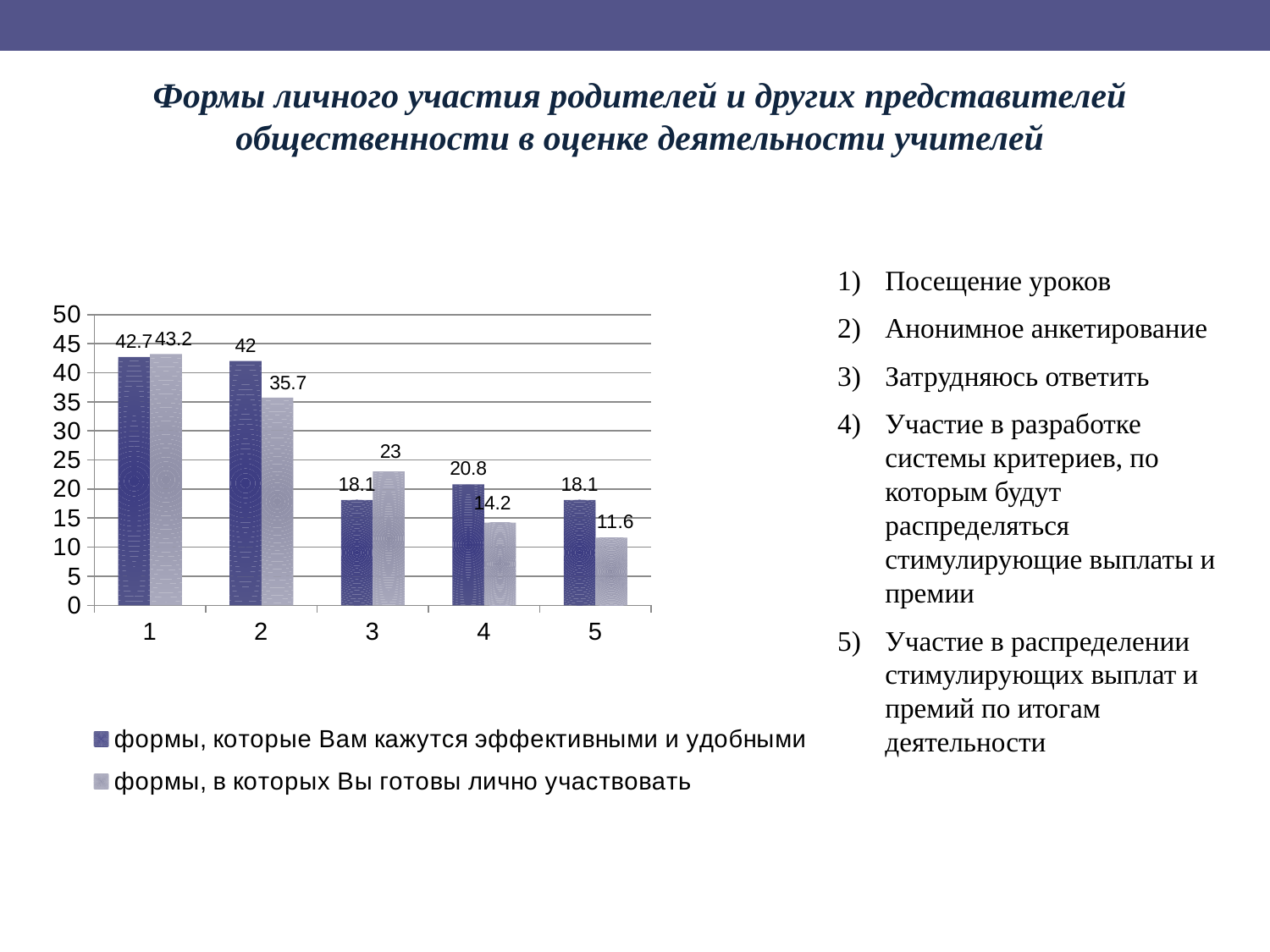
Do the values of the series "формы, в которых Вы готовы лично участвовать" generally rise or fall from category 1 to category 5? fall How many series does the chart legend list? 2 What type of chart is shown on the slide? bar chart What is the value for category 5 in the series "формы, в которых Вы готовы лично участвовать"? 11.6 For category 3, which series has the larger value: "формы, которые Вам кажутся эффективными и удобными" or "формы, в которых Вы готовы лично участвовать"? формы, в которых Вы готовы лично участвовать How many categories are shown on the x axis of the chart? 5 What is the value for category 1 in the series "формы, которые Вам кажутся эффективными и удобными"? 42.7 Which category has the highest value in the series "формы, в которых Вы готовы лично участвовать"? 1 Which category has the lowest value in the series "формы, в которых Вы готовы лично участвовать"? 5 Is the value for category 4 in the series "формы, которые Вам кажутся эффективными и удобными" greater or less than 20? greater What is the difference between the two series' values for category 2? 6.3 What is the value for category 2 in the series "формы, в которых Вы готовы лично участвовать"? 35.7